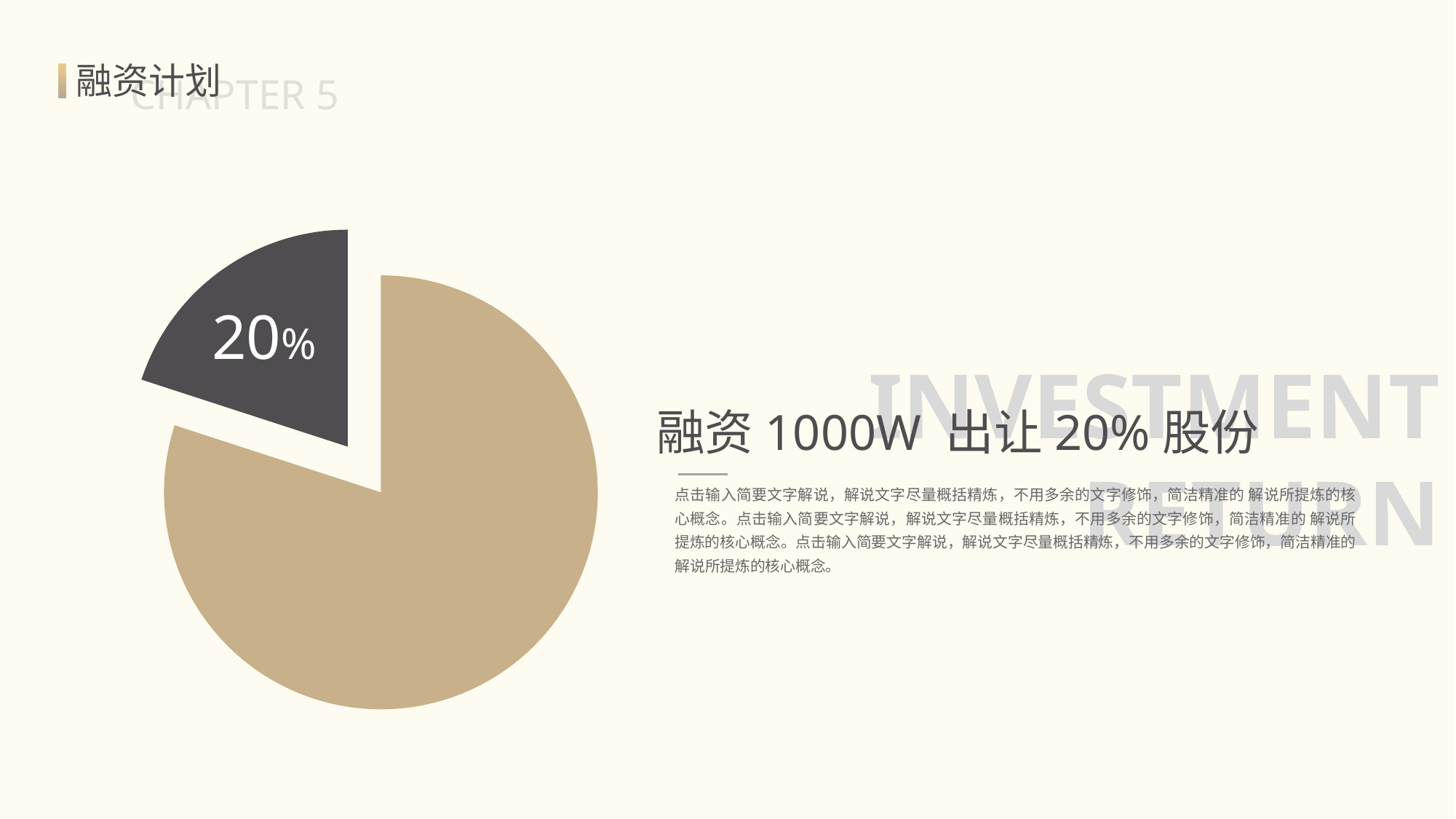
Is the tan slice of the pie chart greater or less than 50% of the pie? greater What colour is the slice labelled 20% in the pie chart? dark grey How many slices does the pie chart have? 2 What value is printed on the dark grey slice of the pie chart? 20% Which slice of the pie chart is the smallest? the dark grey slice (20%) What is the title of the slide containing the pie chart? 融资计划 Which slice of the pie chart is larger, the dark grey slice or the tan slice? the tan slice According to the heading next to the pie chart, what percentage of shares is being offered? 20% What share of the pie does the tan slice represent? 80% What kind of chart is shown on the slide? pie chart